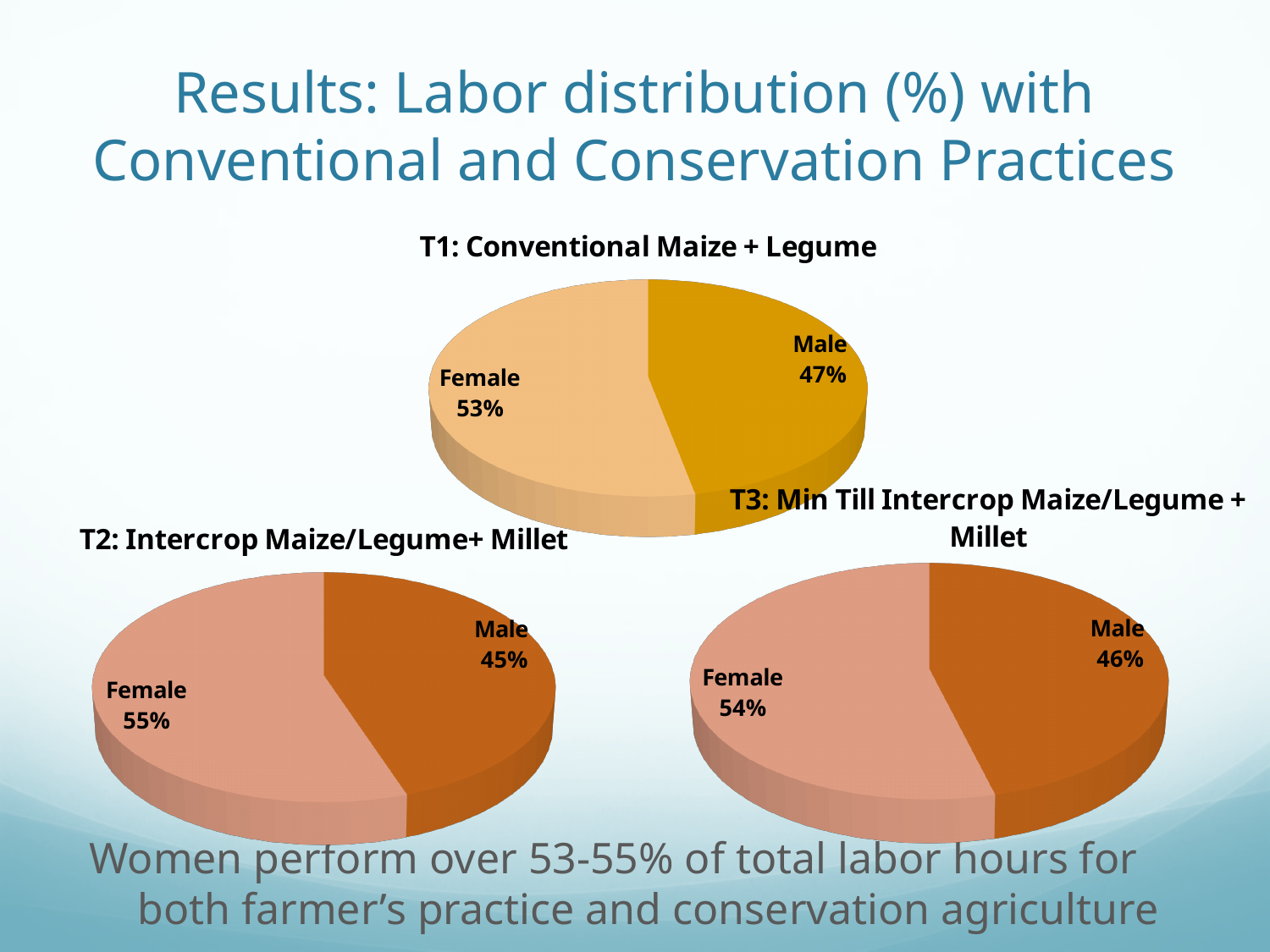
How many slices does the T1: Conventional Maize + Legume chart have? 2 In the T2: Intercrop Maize/Legume+ Millet chart, what is the value for Female? 55% In the T2: Intercrop Maize/Legume+ Millet chart, which is larger, Female or Male? Female In the T3: Min Till Intercrop Maize/Legume + Millet chart, what is the difference between the Female and Male values? 8% In the T1: Conventional Maize + Legume chart, what is the value for Female? 53% What kind of chart is the T3: Min Till Intercrop Maize/Legume + Millet chart? Pie chart In the T1: Conventional Maize + Legume chart, what is the value for Male? 47% In the T2: Intercrop Maize/Legume+ Millet chart, which category has the largest share? Female In the T2: Intercrop Maize/Legume+ Millet chart, what is the value for Male? 45% In the T3: Min Till Intercrop Maize/Legume + Millet chart, what is the value for Female? 54% In the T3: Min Till Intercrop Maize/Legume + Millet chart, what is the value for Male? 46% In the T1: Conventional Maize + Legume chart, which category has the smallest share? Male